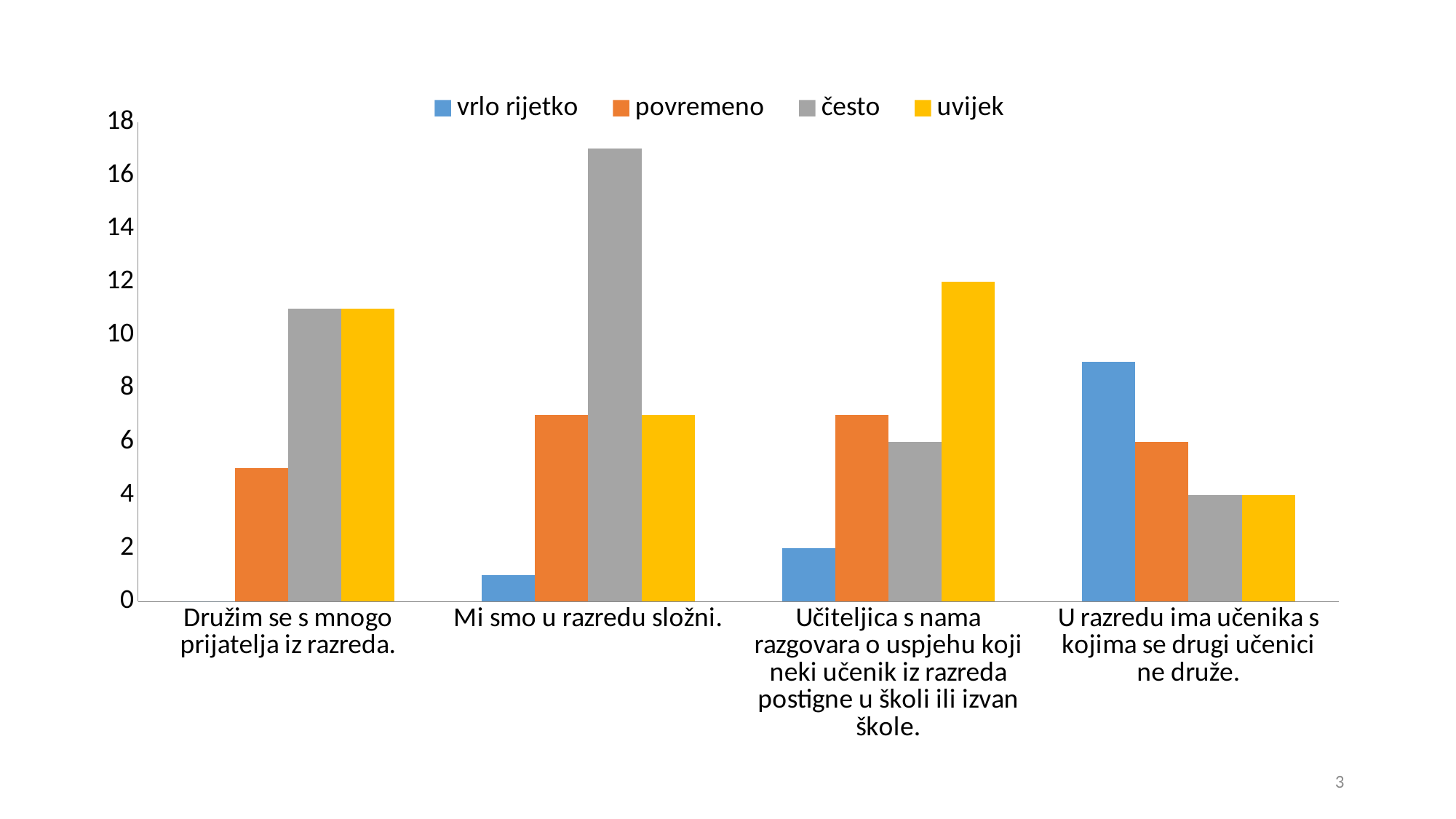
What is the value of 'vrlo rijetko' for 'Učiteljica s nama razgovara o uspjehu koji neki učenik iz razreda postigne u školi ili izvan škole.'? 2 Which series has the lowest value for 'Mi smo u razredu složni.'? vrlo rijetko How many categories are shown on the x axis? 4 What kind of chart is shown on the slide? bar chart How many series does the legend list? 4 Which is larger for 'Družim se s mnogo prijatelja iz razreda.': 'povremeno' or 'često'? često What is the value of 'često' for 'U razredu ima učenika s kojima se drugi učenici ne druže.'? 4 What is the value of 'povremeno' for 'U razredu ima učenika s kojima se drugi učenici ne druže.'? 6 Which series has the highest value for 'Mi smo u razredu složni.'? često What is the value of 'uvijek' for 'Učiteljica s nama razgovara o uspjehu koji neki učenik iz razreda postigne u školi ili izvan škole.'? 12 Is the value of 'vrlo rijetko' for 'U razredu ima učenika s kojima se drugi učenici ne druže.' greater or less than 8? greater Is the value of 'često' for 'Mi smo u razredu složni.' greater or less than 16? greater